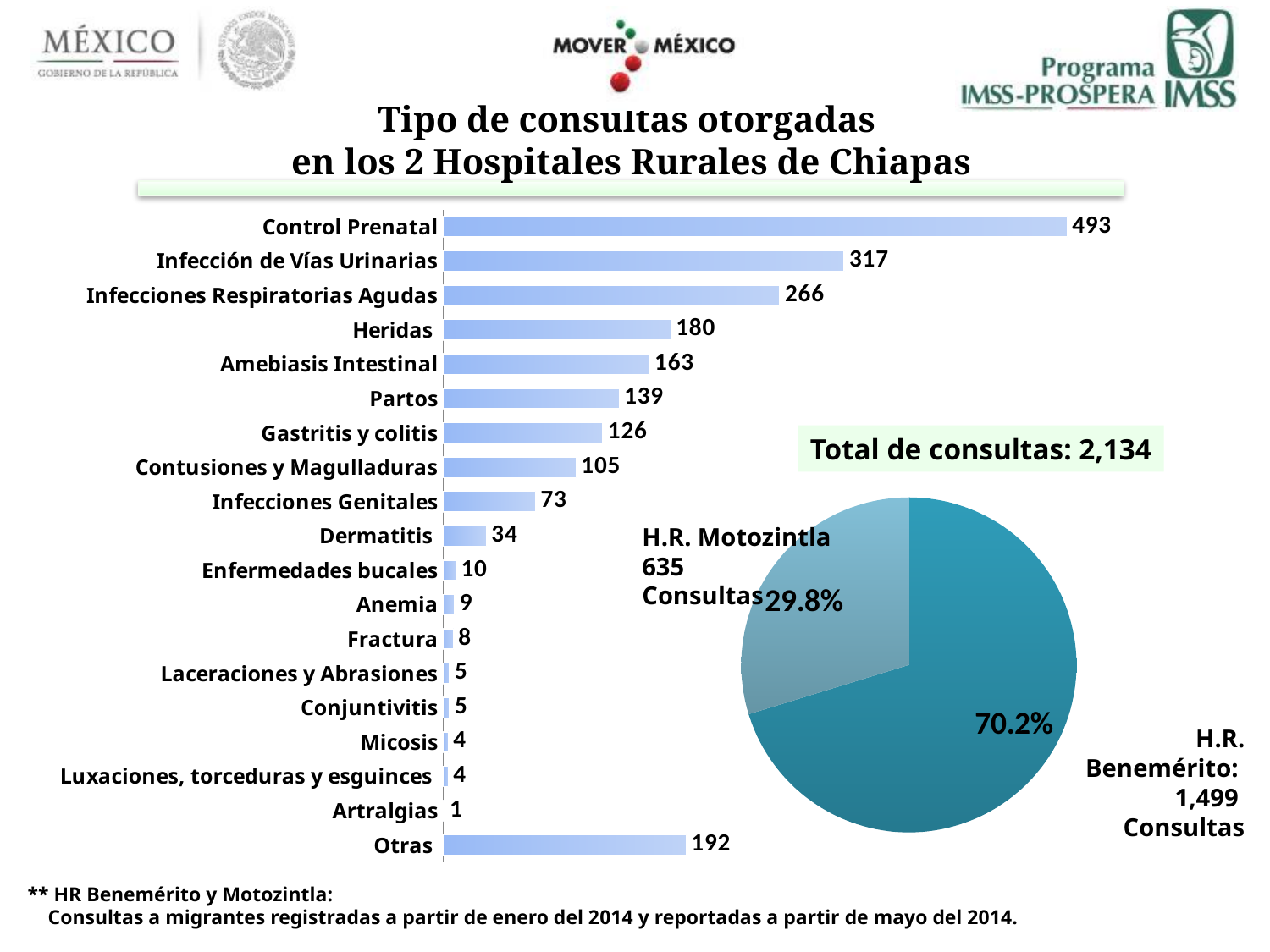
In the bar chart, what is the value for Otras? 192 In the bar chart, how many consultations are shown for Control Prenatal? 493 In the bar chart, what is the difference between Infección de Vías Urinarias and Infecciones Respiratorias Agudas? 51 In the bar chart, which category has the lowest value? Artralgias In the pie chart, how many consultations are attributed to H.R. Motozintla? 635 In the bar chart, what is the value for Partos? 139 What type of chart is used on the left side of the slide to show the types of consultations? Bar chart In the pie chart, what share of consultations corresponds to H.R. Benemérito? 70.2% In the bar chart, which is larger: Heridas or Amebiasis Intestinal? Heridas What total number of consultations is stated on the slide? 2,134 How many categories does the bar chart show? 19 In the bar chart, which category has the highest value? Control Prenatal